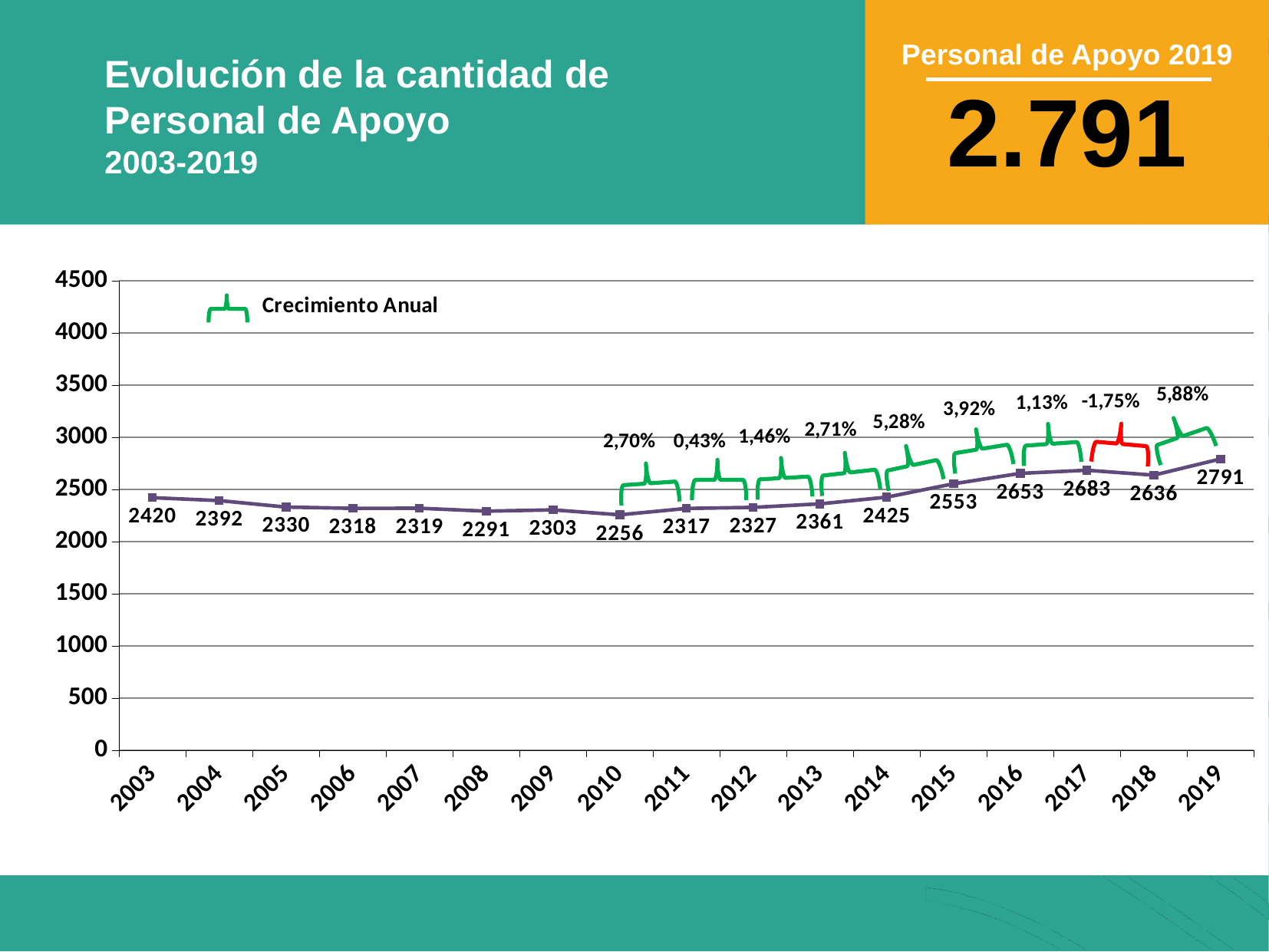
Which is larger, the value for 2017 or the value for 2018? 2017 What is the difference between the values for 2019 and 2018? 155 What is the value for 2010? 2256 What kind of chart is shown? line chart Is the value for 2015 greater or less than 2500? greater What is the value for 2019? 2791 Which year has the highest value? 2019 Which year has the lowest value? 2010 What annual growth percentage is shown between 2018 and 2019? 5,88% What is the value for 2003? 2420 How many years are plotted on the x axis? 17 Do the values rise or fall from 2010 to 2017? rise